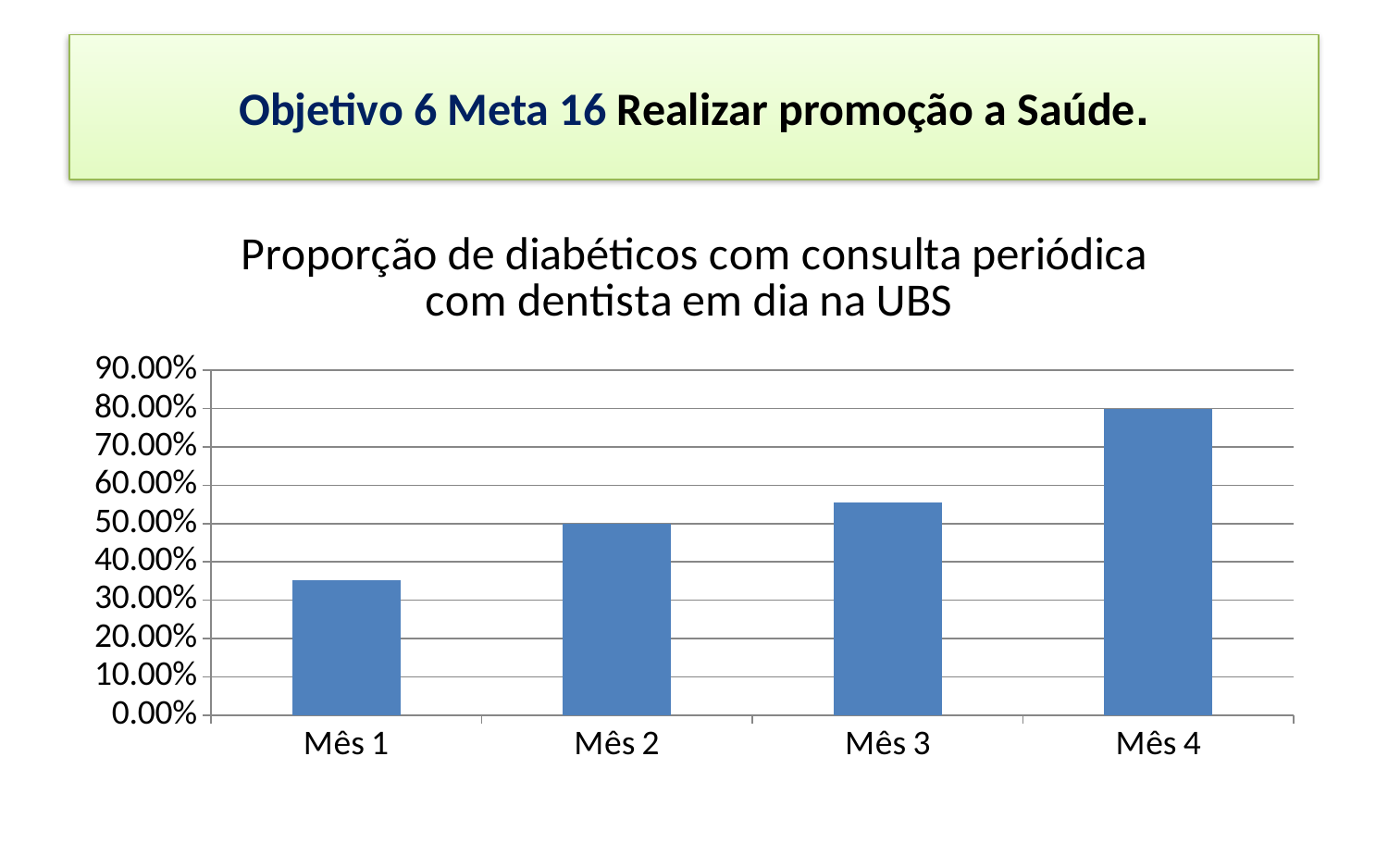
Do the values rise or fall from Mês 1 to Mês 4? rise How many months (categories) are shown on the x axis? 4 Which month has the lowest proportion? Mês 1 What is the value for Mês 2? 50.00% What is the title of the chart? Proporção de diabéticos com consulta periódica com dentista em dia na UBS What is the value for Mês 4? 80.00% Is the value for Mês 1 greater or less than 40.00%? less Which is larger, the value for Mês 3 or the value for Mês 2? Mês 3 Is the value for Mês 3 greater or less than 50.00%? greater What type of chart is shown on the slide? bar chart Which month has the highest proportion? Mês 4 Is the value for Mês 3 greater or less than 60.00%? less